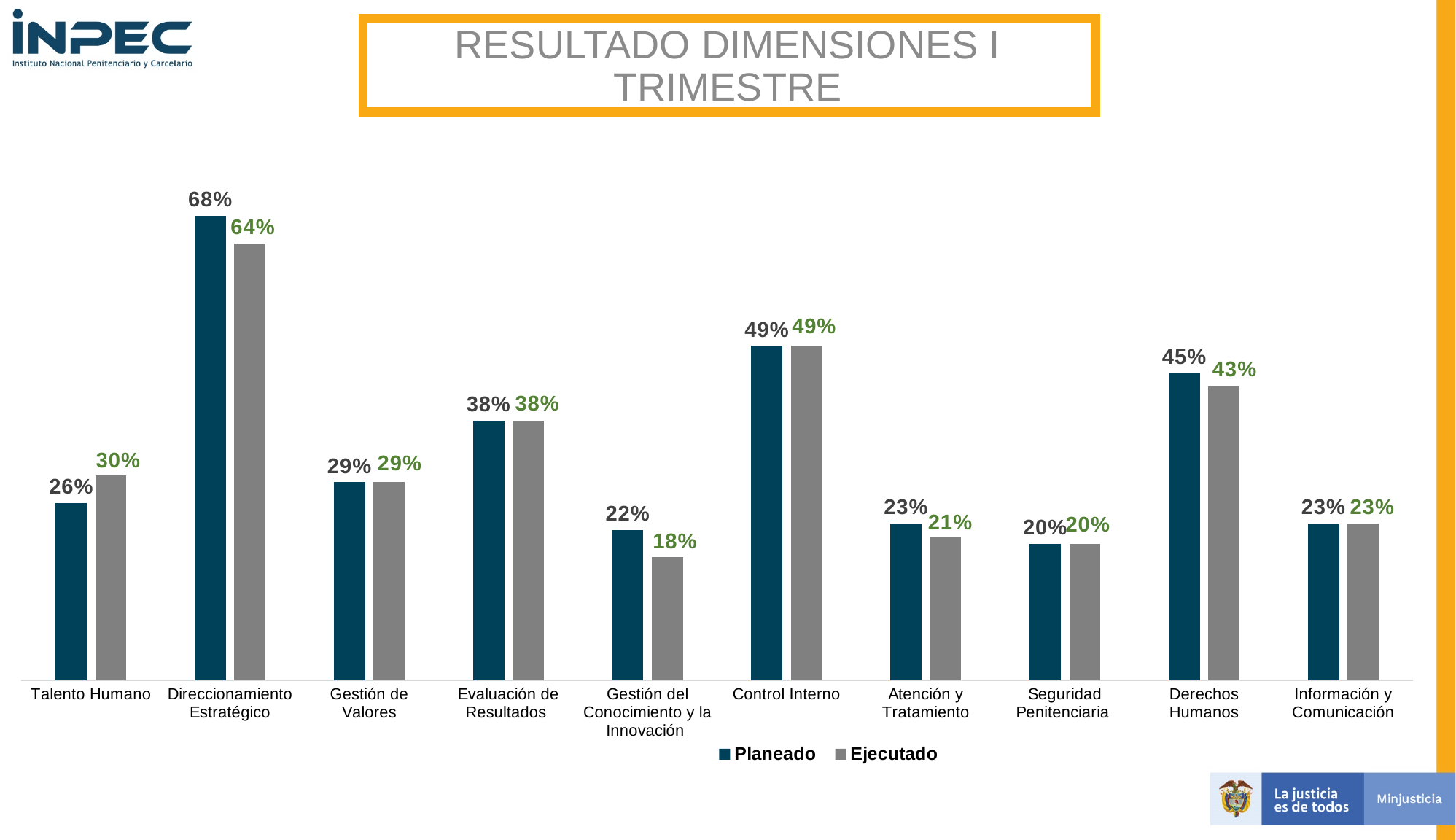
What is the Planeado value for Direccionamiento Estratégico? 68% Which category has the highest Planeado value? Direccionamiento Estratégico What are the two series named in the legend? Planeado and Ejecutado What is the difference between the Planeado and Ejecutado values for Derechos Humanos? 2% Which is larger for Talento Humano, the Planeado value or the Ejecutado value? Ejecutado How many categories are shown on the x axis? 10 Which category has the lowest Ejecutado value? Gestión del Conocimiento y la Innovación What is the Ejecutado value for Gestión del Conocimiento y la Innovación? 18% What kind of chart is shown on the slide? Bar chart What is the difference between the Planeado values for Direccionamiento Estratégico and Control Interno? 19% What is the Ejecutado value for Talento Humano? 30% How many series does the legend list? 2